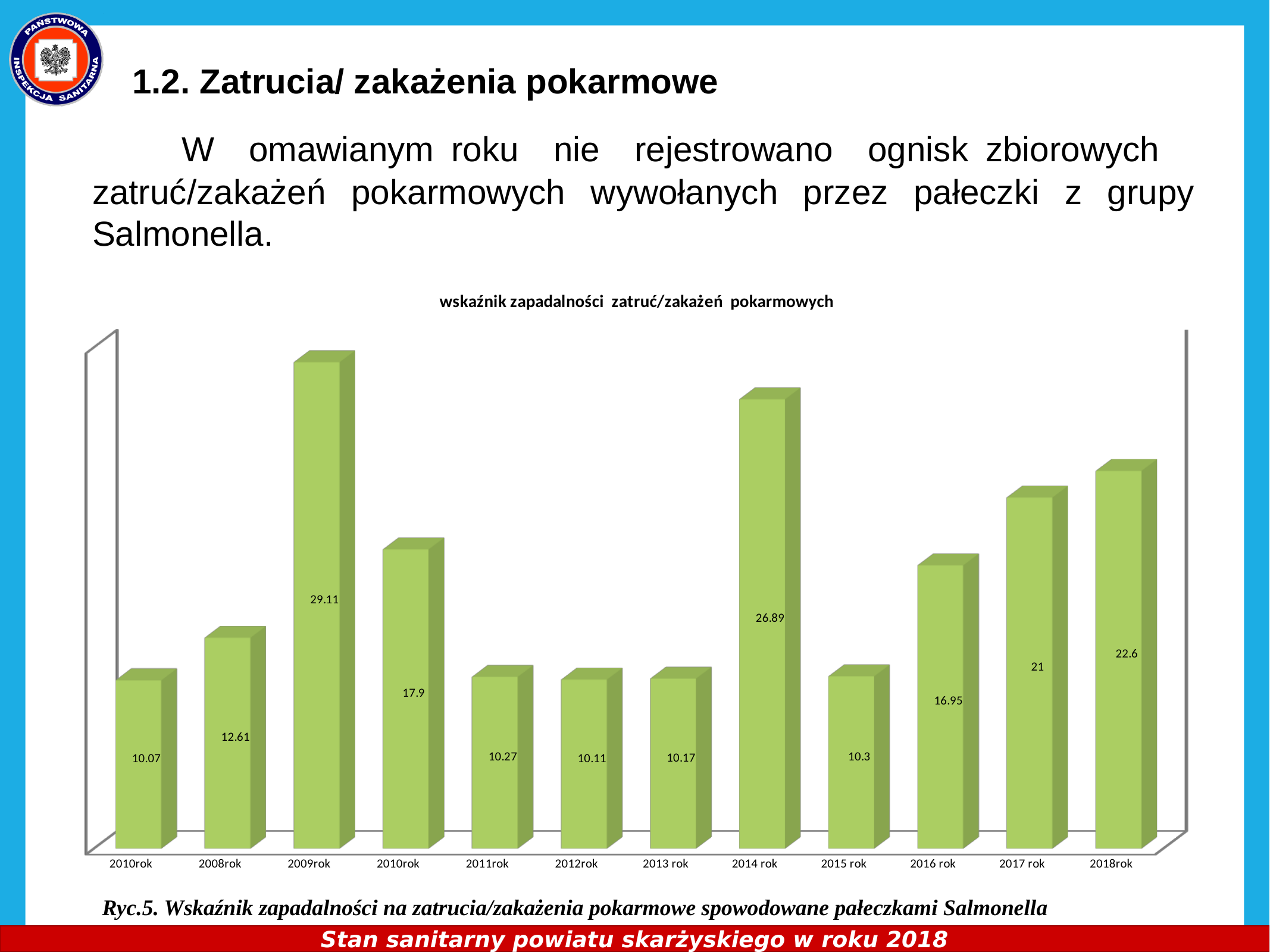
What is the value for 2018rok? 22.6 What is the difference between the values for 2018rok and 2017 rok? 1.6 What is the lowest value shown in the chart? 10.07 How many bars are shown in the chart? 12 What is the value for 2009rok? 29.11 What is the value for 2012rok? 10.11 What is the value for 2016 rok? 16.95 Do the values rise or fall from 2015 rok to 2018rok? rise What is the value for 2014 rok? 26.89 Which is larger, the value for 2014 rok or the value for 2017 rok? 2014 rok What type of chart is shown on the slide? bar chart Which category has the highest value? 2009rok